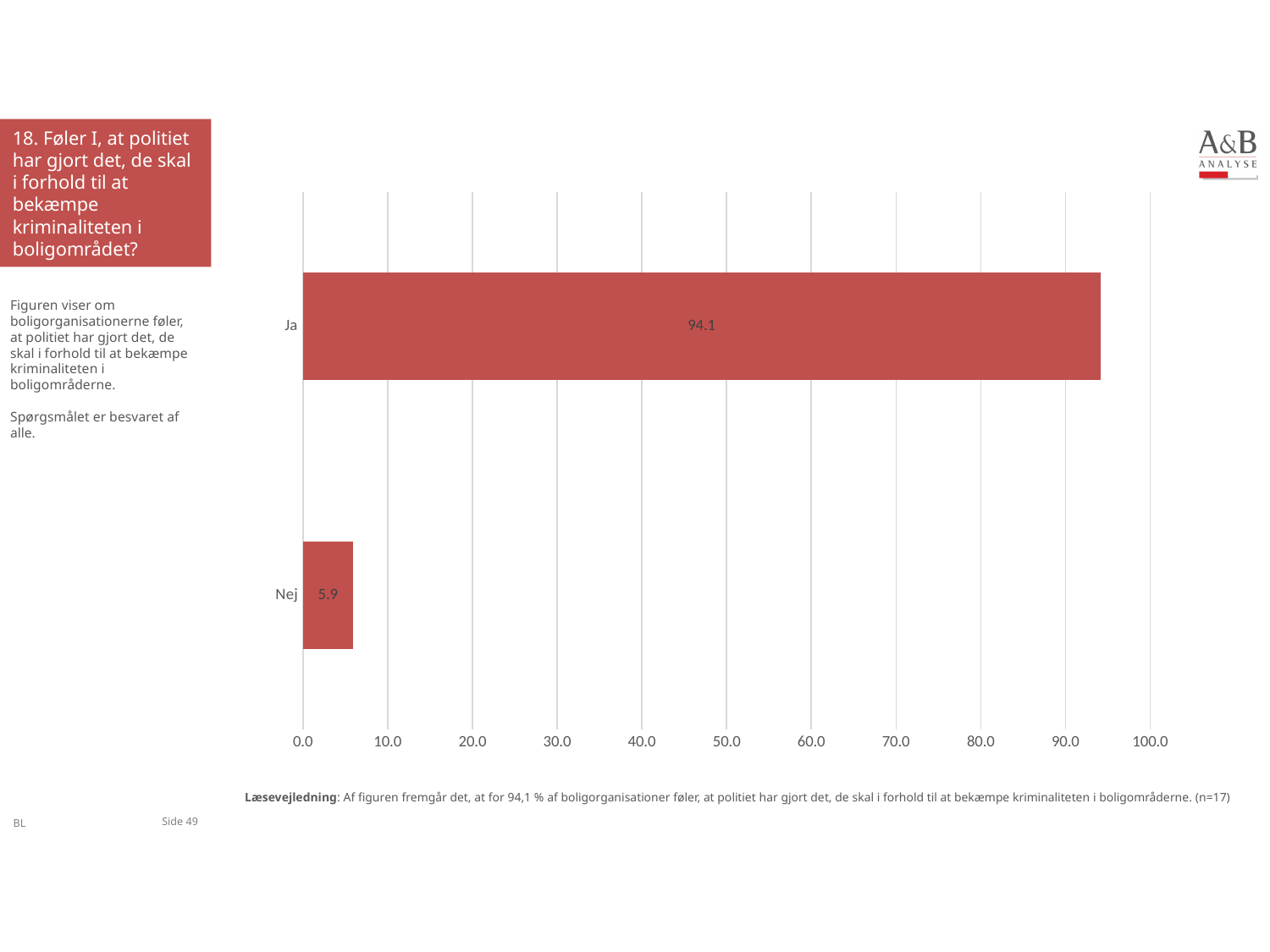
Which category has the lowest value? Nej What is the highest value shown on the x axis? 100.0 How many categories are shown in the chart? 2 What is the value for "Nej"? 5.9 Is the value for "Nej" greater or less than 10.0? less What is the value for "Ja"? 94.1 What is the difference between the values for "Ja" and "Nej"? 88.2 What kind of chart is shown on the slide? bar chart Which is larger, the value for "Ja" or the value for "Nej"? Ja What is the total of the values for "Ja" and "Nej"? 100.0 Is the value for "Ja" greater or less than 90.0? greater Which category has the highest value? Ja